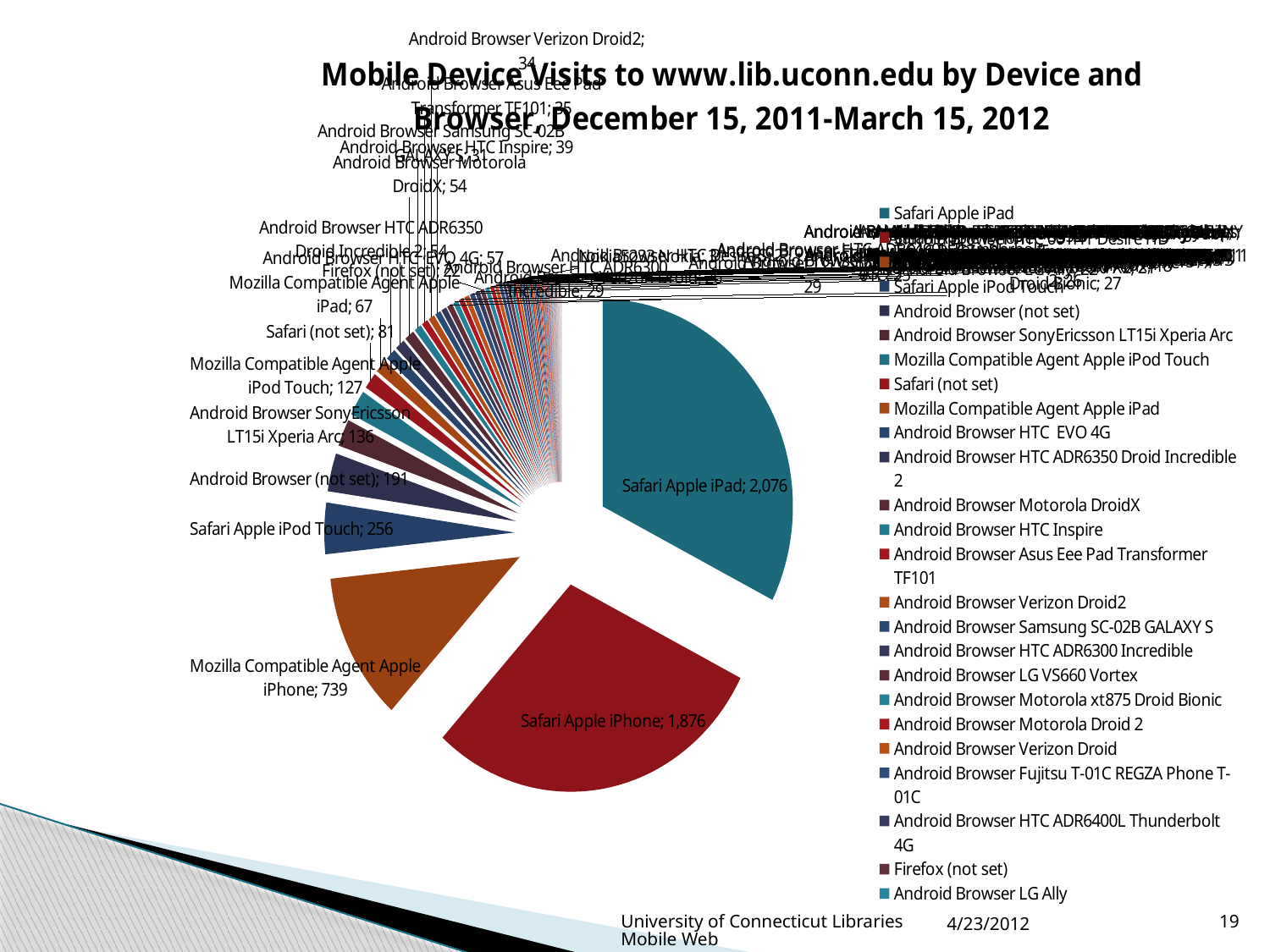
What is the difference in visits between Safari Apple iPad and Safari Apple iPhone? 200 What is the difference in visits between Android Browser (not set) and Mozilla Compatible Agent Apple iPod Touch? 64 What kind of chart is shown on the slide? pie chart How many visits are shown for Safari Apple iPod Touch? 256 How many visits are shown for Android Browser SonyEricsson LT15i Xperia Arc? 136 Which has more visits, Safari (not set) or Mozilla Compatible Agent Apple iPad? Safari (not set) How many visits are shown for Safari Apple iPad? 2,076 Which device and browser has the largest slice of the pie? Safari Apple iPad How many visits are shown for Mozilla Compatible Agent Apple iPhone? 739 Which has more visits, Mozilla Compatible Agent Apple iPhone or Safari Apple iPod Touch? Mozilla Compatible Agent Apple iPhone What is the title of the chart? Mobile Device Visits to www.lib.uconn.edu by Device and Browser, December 15, 2011-March 15, 2012 How many visits are shown for Safari Apple iPhone? 1,876